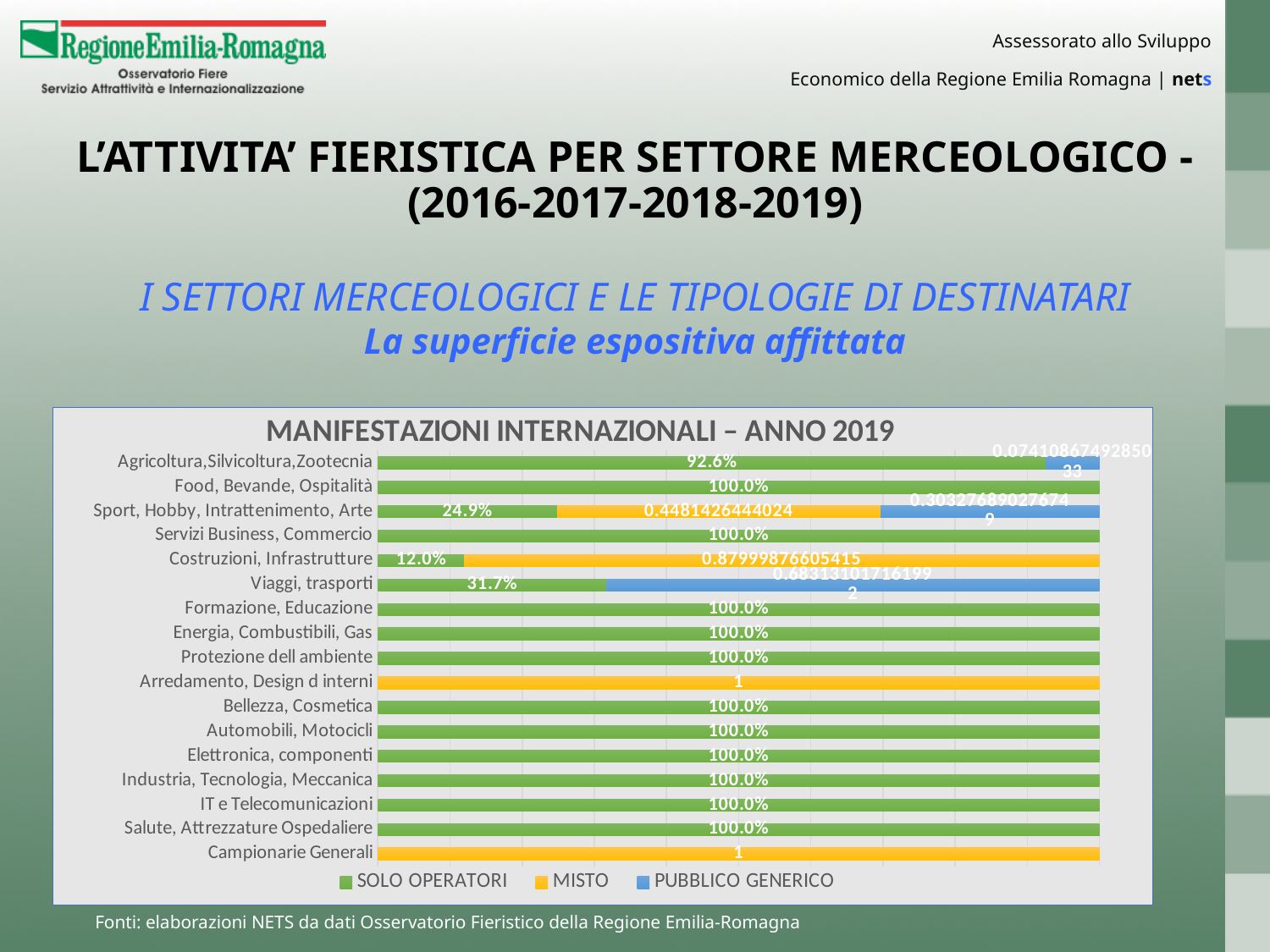
What is the SOLO OPERATORI value for Viaggi, trasporti? 31.7% What is the SOLO OPERATORI value for Agricoltura, Silvicoltura, Zootecnia? 92.6% What is the difference between the SOLO OPERATORI values for Viaggi, trasporti and Costruzioni, Infrastrutture? 19.7% What kind of chart is shown on the slide? bar chart What is the SOLO OPERATORI value for Sport, Hobby, Intrattenimento, Arte? 24.9% How many categories are shown on the chart? 17 What is the title of the chart? MANIFESTAZIONI INTERNAZIONALI – ANNO 2019 Which is larger, the SOLO OPERATORI value for Viaggi, trasporti or for Sport, Hobby, Intrattenimento, Arte? Viaggi, trasporti How many series does the chart legend list? 3 What is the SOLO OPERATORI value for Costruzioni, Infrastrutture? 12.0% Which category has the lowest SOLO OPERATORI value? Costruzioni, Infrastrutture What is the SOLO OPERATORI value for Food, Bevande, Ospitalità? 100.0%